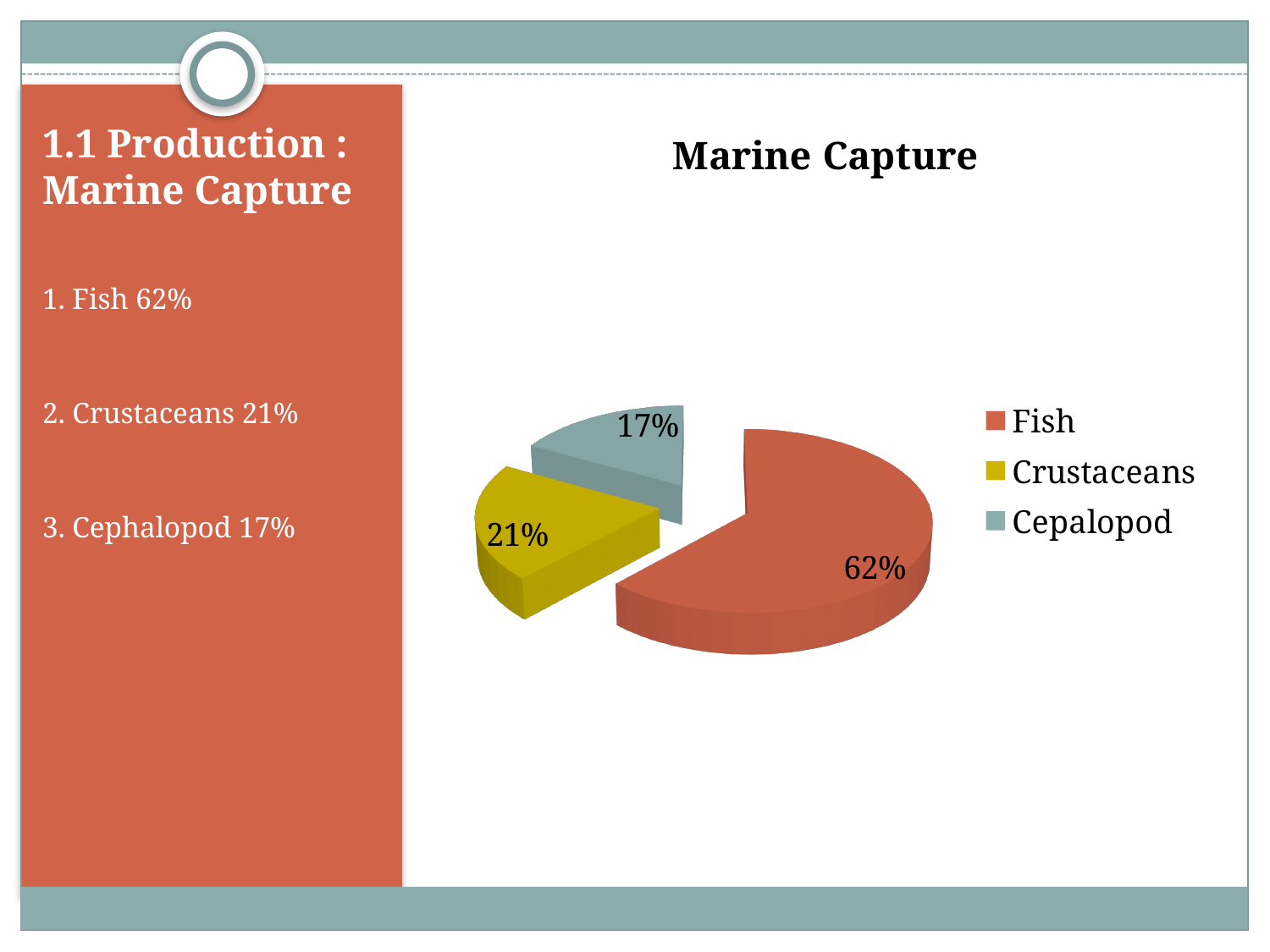
What is the title of the chart? Marine Capture What colour is the Fish slice in the pie chart? Red What share of the pie does Cepalopod account for? 17% How many entries does the legend list? 3 What share of the pie does Crustaceans account for? 21% Which category has the smallest slice of the pie? Cepalopod What type of chart is shown on the slide? Pie chart What is the difference in percentage points between Fish and Crustaceans? 41 Which category has the largest slice of the pie? Fish How many slices does the pie chart have? 3 What share of the pie does Fish account for? 62% Which is larger, the share for Crustaceans or the share for Cepalopod? Crustaceans